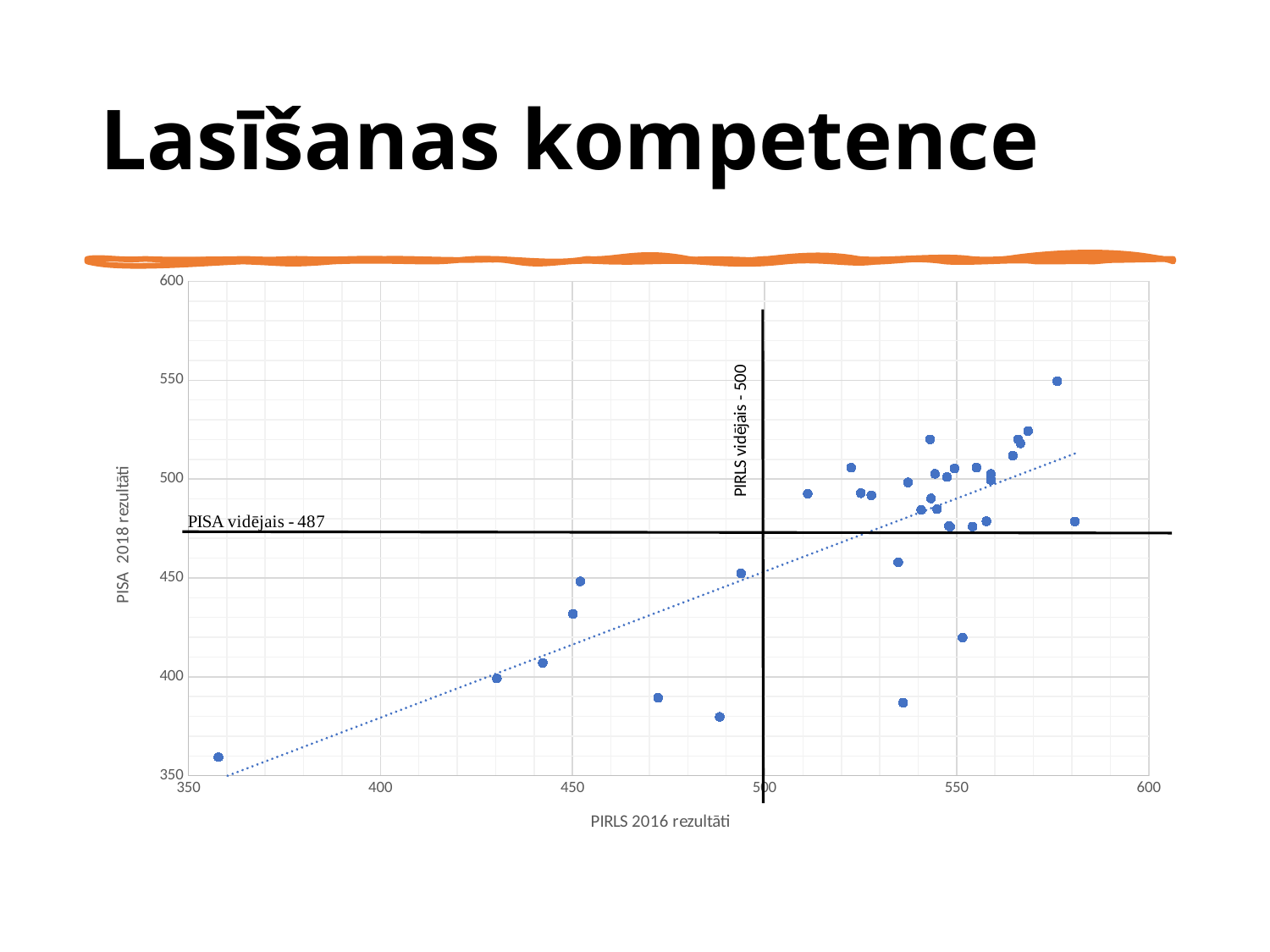
Is the PISA 2018 value of the lowest point on the chart greater or less than 400? less What PISA average value is marked by the horizontal line on the chart? 487 What PIRLS average value is marked by the vertical line on the chart? 500 Which is larger, the PIRLS average marked on the chart or the PISA average marked on the chart? PIRLS average (500) What is the difference between the PIRLS average (500) and the PISA average (487) marked on the chart? 13 What is the title of the x axis? PIRLS 2016 rezultāti Is the PISA 2018 value of the highest point on the chart greater or less than 500? greater What kind of chart is shown on the slide? scatter plot Do the PISA 2018 values generally rise or fall as the PIRLS 2016 values increase along the x axis? rise What is the title of the y axis? PISA 2018 rezultāti